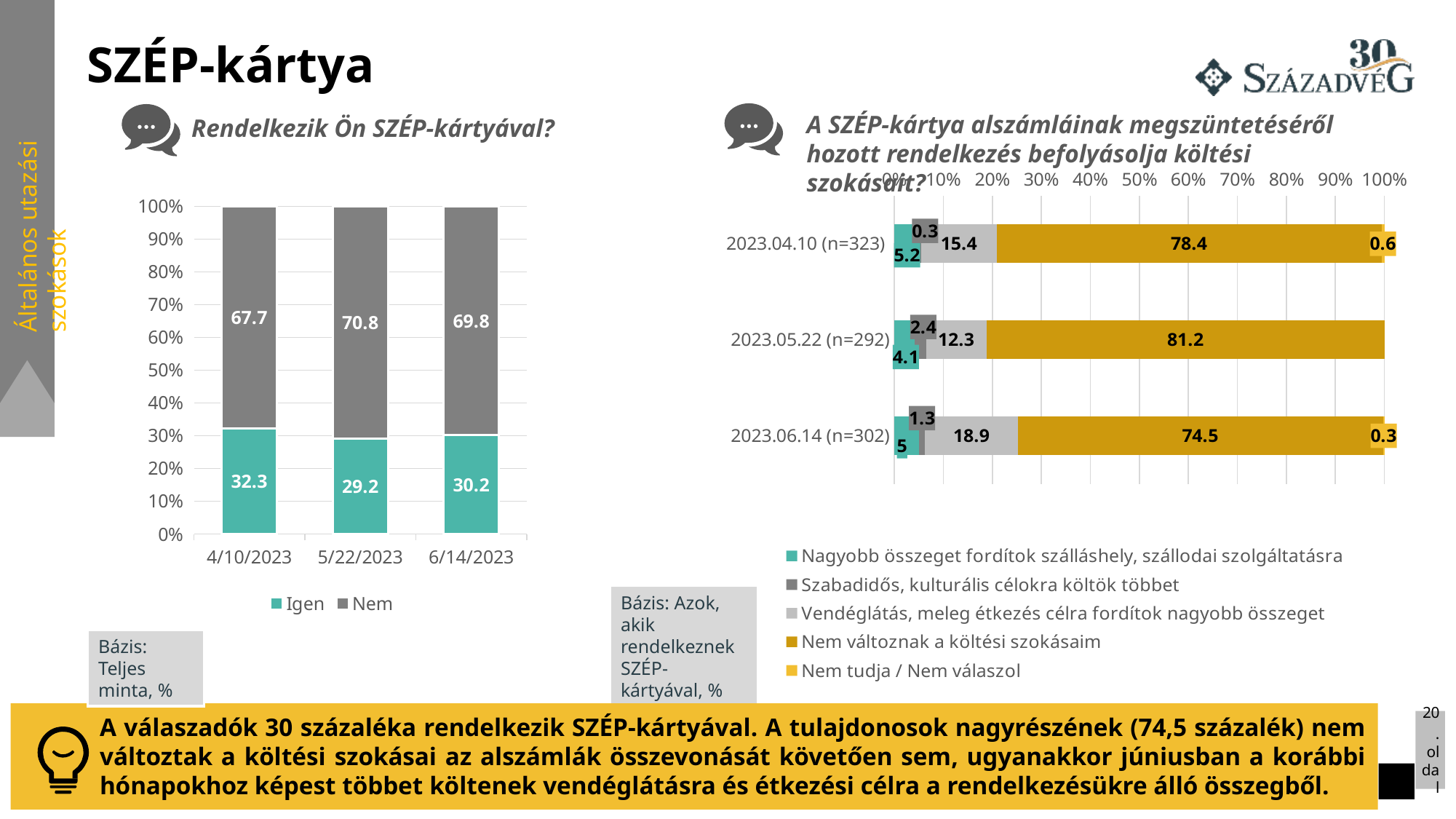
In the right chart about the SZÉP-kártya alszámlák, how many series does the legend list? 5 In the right chart about the SZÉP-kártya alszámlák, what is the value for 'Nem változnak a költési szokásaim' for 2023.05.22 (n=292)? 81.2 In the right chart about the SZÉP-kártya alszámlák, which date has the highest value for 'Nem változnak a költési szokásaim'? 2023.05.22 (n=292) In the left chart 'Rendelkezik Ön SZÉP-kártyával?', on which date is the 'Igen' value lowest? 5/22/2023 In the right chart about the SZÉP-kártya alszámlák, how many dates (categories) are shown? 3 In the left chart 'Rendelkezik Ön SZÉP-kártyával?', what is the difference between the 'Nem' and 'Igen' values on 6/14/2023? 39.6 In the left chart 'Rendelkezik Ön SZÉP-kártyával?', what is the value for 'Igen' on 4/10/2023? 32.3 In the right chart about the SZÉP-kártya alszámlák, is the 'Vendéglátás, meleg étkezés célra fordítok nagyobb összeget' value larger for 2023.04.10 (n=323) or 2023.06.14 (n=302)? 2023.06.14 (n=302) In the right chart about the SZÉP-kártya alszámlák, what is the value for 'Vendéglátás, meleg étkezés célra fordítok nagyobb összeget' for 2023.06.14 (n=302)? 18.9 What type of chart is the left chart 'Rendelkezik Ön SZÉP-kártyával?'? Stacked bar chart In the left chart 'Rendelkezik Ön SZÉP-kártyával?', how many series does the legend list? 2 In the left chart 'Rendelkezik Ön SZÉP-kártyával?', what is the value for 'Nem' on 5/22/2023? 70.8